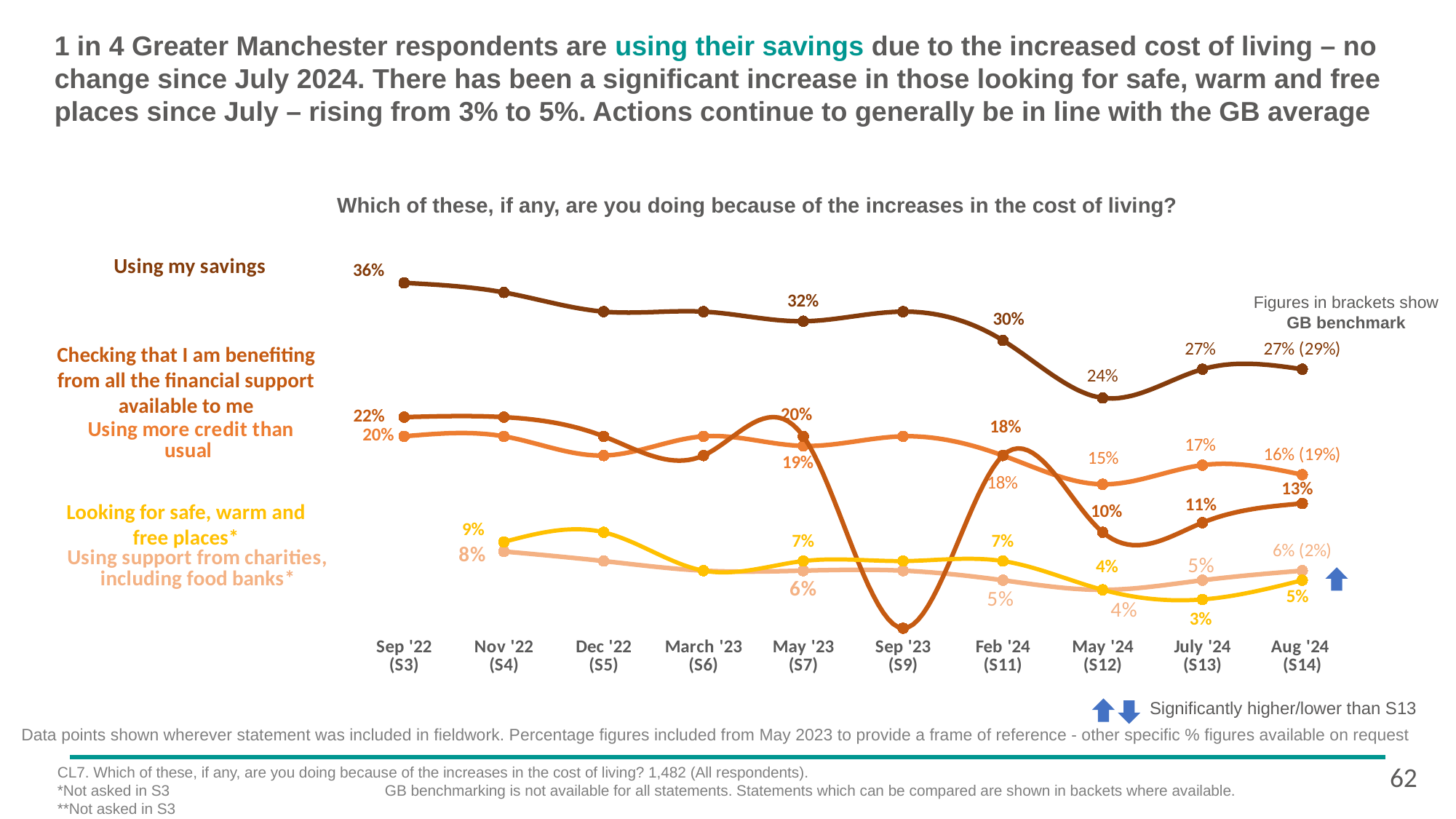
What is the difference between the 'Using my savings' values in Sep '22 (S3) and Aug '24 (S14)? 9 percentage points Which statement has the highest value in Aug '24 (S14)? Using my savings How many time points are shown on the x axis? 10 How many statements (series) are plotted on the chart? 5 What is the value for 'Using more credit than usual' in May '24 (S12)? 15% Which statement has the lowest value in July '24 (S13)? Looking for safe, warm and free places What is the GB benchmark figure shown in brackets for 'Using my savings' in Aug '24 (S14)? 29% What is the value for 'Checking that I am benefiting from all the financial support available to me' in May '24 (S12)? 10% Which is larger: the 'Using my savings' value in Sep '22 (S3) or in May '23 (S7)? Sep '22 (S3) What is the value for 'Using my savings' in Aug '24 (S14)? 27% What is the value for 'Looking for safe, warm and free places' in July '24 (S13)? 3% What kind of chart is shown on the slide? Line chart